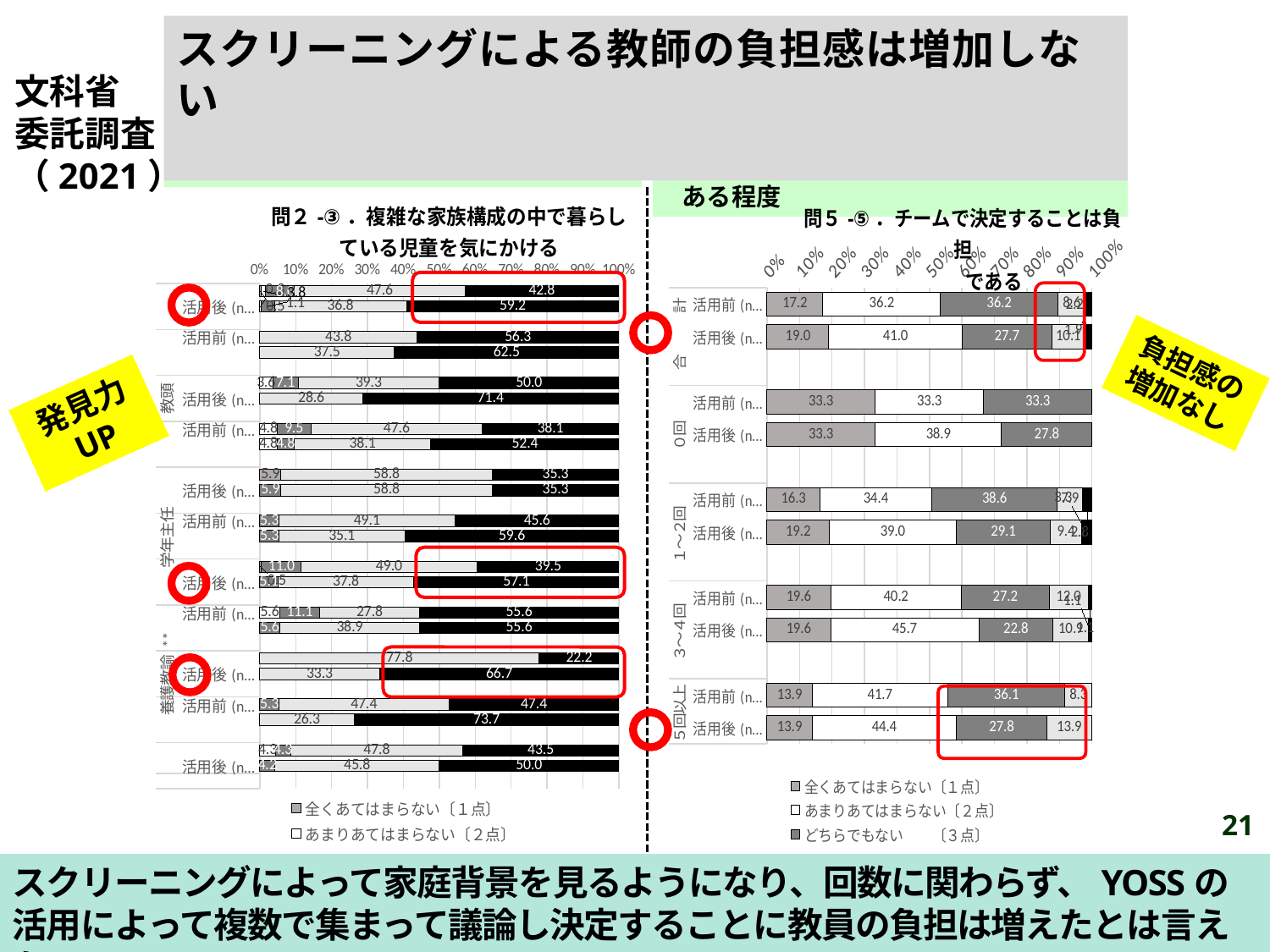
In the right-hand chart (問5-⑤), what is the difference between the どちらでもない values for 5回以上 活用前 and 5回以上 活用後? 8.3 In the right-hand chart (問5-⑤), what is the value of あまりあてはまらない for 5回以上 活用後? 44.4 In the right-hand chart (問5-⑤), what is the first entry listed in the legend? 全くあてはまらない〔1点〕 In the right-hand chart (問5-⑤), what is the value of あまりあてはまらない for 0回 活用後? 38.9 What kind of chart is the right-hand chart (問5-⑤. チームで決定することは負担である)? bar chart In the right-hand chart (問5-⑤), what is the value of 全くあてはまらない for 0回 活用前? 33.3 In the right-hand chart (問5-⑤), what is the value of 全くあてはまらない for 合計 活用後? 19.0 In the right-hand chart (問5-⑤), what is the value of どちらでもない for 1~2回 活用後? 29.1 In the right-hand chart (問5-⑤), for 3~4回, which has the larger あまりあてはまらない value, 活用前 or 活用後? 活用後 In the right-hand chart (問5-⑤), what is the value of どちらでもない for 5回以上 活用前? 36.1 In the right-hand chart (問5-⑤), what is the value of あまりあてはまらない for 合計 活用前? 36.2 What kind of chart is the left-hand chart (問2-③. 複雑な家族構成の中で暮らしている児童を気にかける)? bar chart